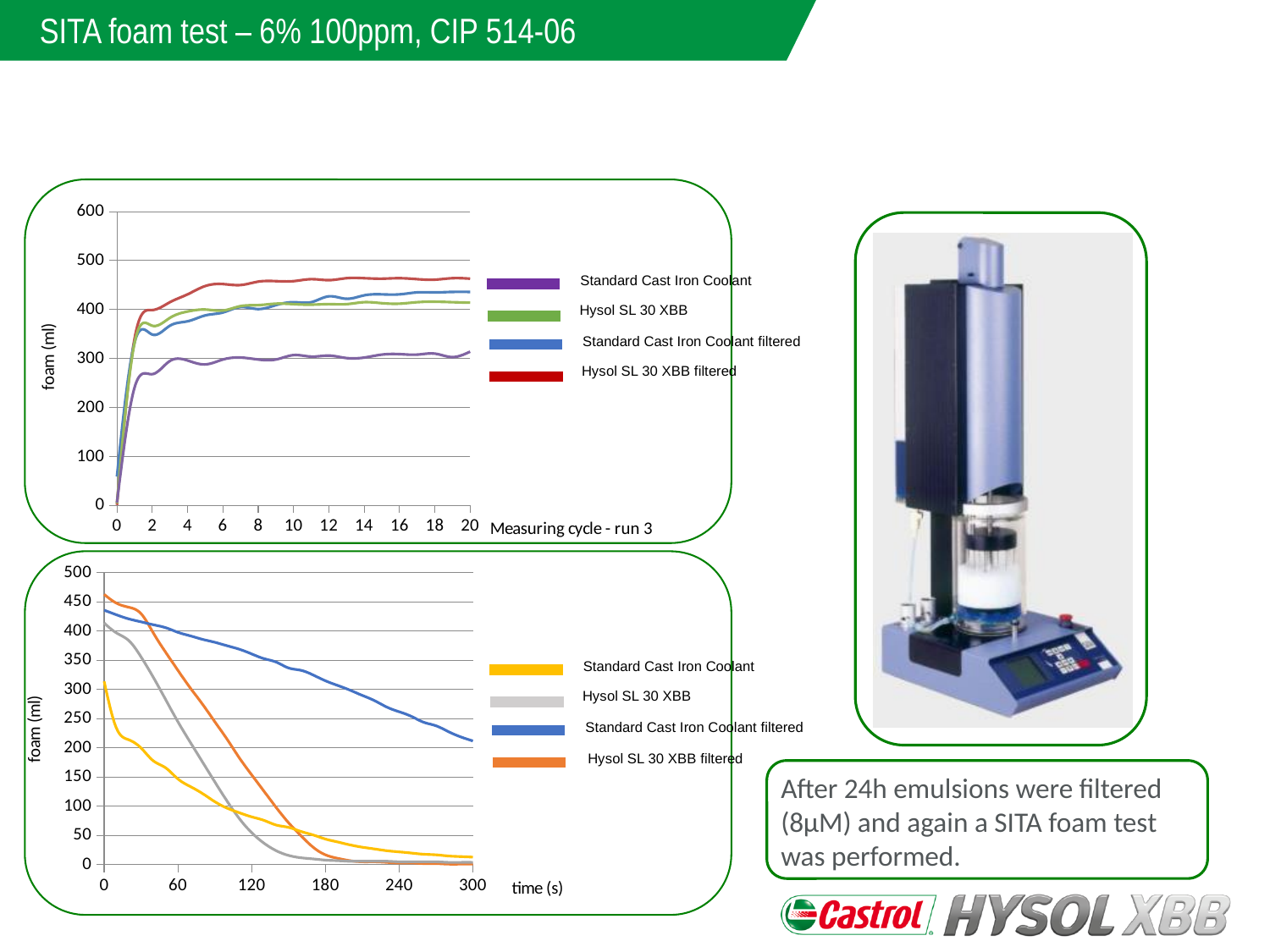
In the top chart (Measuring cycle - run 3), is the foam value for Standard Cast Iron Coolant at cycle 20 greater or less than 400? less In the bottom chart (time (s)), which series has the highest foam value at 300 s? Standard Cast Iron Coolant filtered In the bottom chart (time (s)), is the foam value for Standard Cast Iron Coolant filtered at 300 s greater or less than 150? greater In the bottom chart (time (s)), do the foam values rise or fall as time increases? fall In the bottom chart (time (s)), which series has the highest foam value at 0 s? Hysol SL 30 XBB filtered In the top chart (Measuring cycle - run 3), which series has the highest foam value at measuring cycle 20? Hysol SL 30 XBB filtered How many series does the legend of the top chart (Measuring cycle - run 3) list? 4 In the top chart (Measuring cycle - run 3), do the foam values generally rise or fall as the measuring cycle increases? rise In the bottom chart (time (s)), is the foam value for Standard Cast Iron Coolant at 0 s greater or less than 400? less What kind of chart is the top chart (Measuring cycle - run 3)? line chart In the top chart (Measuring cycle - run 3), which series has the lowest foam value at measuring cycle 20? Standard Cast Iron Coolant What is the label of the x axis of the bottom chart? time (s)